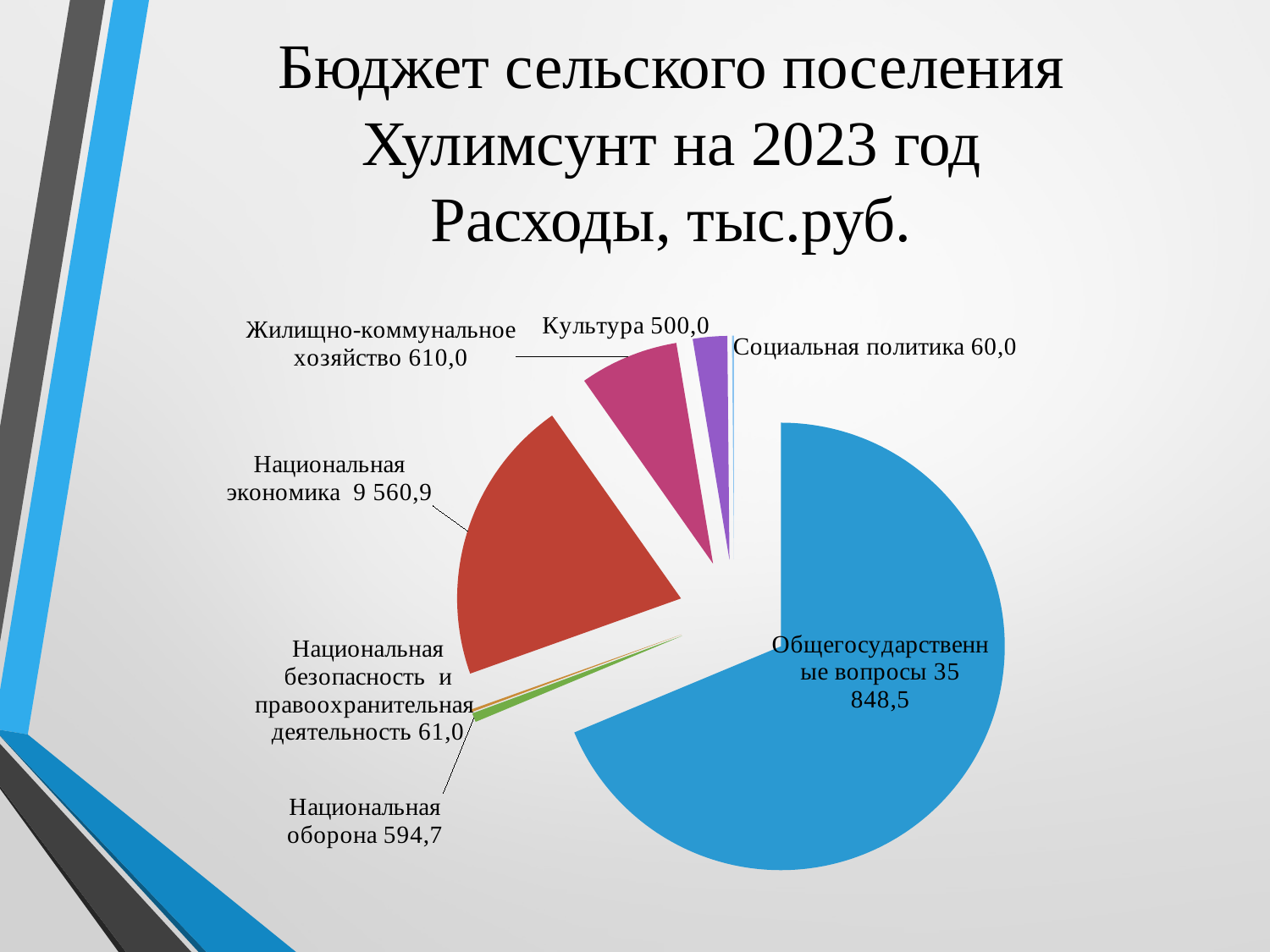
Which category has the smallest value in the pie chart? Социальная политика Which category has the largest value in the pie chart? Общегосударственные вопросы What is the difference between Жилищно-коммунальное хозяйство and Культура? 110,0 What is the difference between Жилищно-коммунальное хозяйство and Национальная оборона? 15,3 What is the value for Культура? 500,0 What kind of chart is shown on the slide? Pie chart What is the value for Национальная экономика? 9 560,9 What is the value for Национальная оборона? 594,7 What is the value for Общегосударственные вопросы? 35 848,5 What unit of measurement is stated in the chart title? тыс.руб. How many categories (slices) does the pie chart show? 7 Which is larger: Национальная экономика or Национальная оборона? Национальная экономика